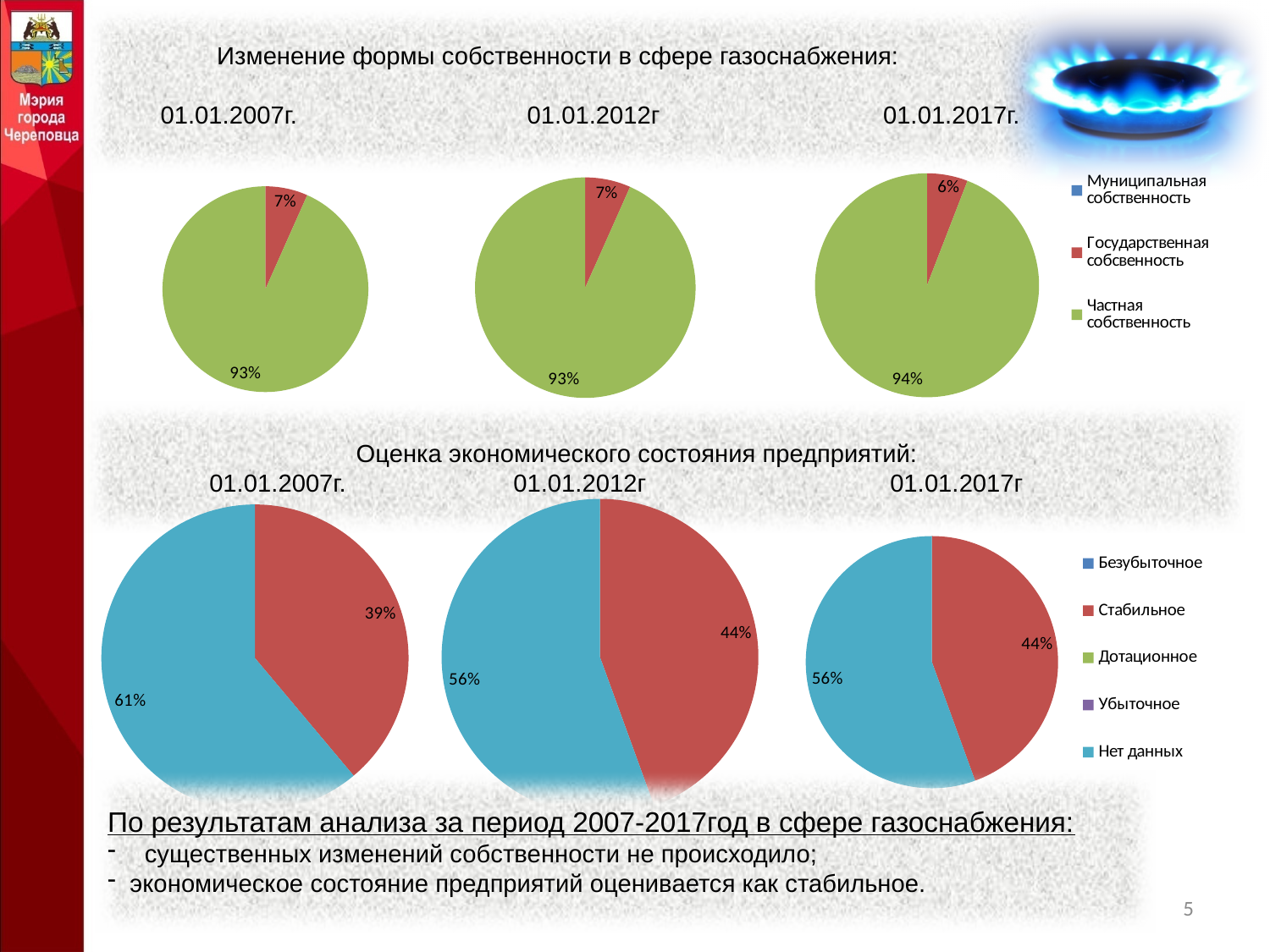
What type of chart is used for the top-row charts (Изменение формы собственности в сфере газоснабжения)? Pie chart In the bottom-row chart for 01.01.2017 (Оценка экономического состояния предприятий), what share is labelled for Стабильное? 44% In the top-row chart for 01.01.2017 (Изменение формы собственности в сфере газоснабжения), what share is labelled for Государственная собсвенность? 6% In the bottom-row chart for 01.01.2012 (Оценка экономического состояния предприятий), what share is labelled for Нет данных? 56% In the top-row chart for 01.01.2007 (Изменение формы собственности в сфере газоснабжения), what share is labelled for Частная собственность? 93% In the bottom-row chart for 01.01.2007, which is larger: the Стабильное slice or the Нет данных slice? Нет данных In the bottom-row chart for 01.01.2007, what is the difference between the Нет данных share and the Стабильное share? 22% In the top-row chart for 01.01.2017, which ownership form has the largest slice? Частная собственность In the top-row chart for 01.01.2012 (Изменение формы собственности в сфере газоснабжения), what share is labelled for Частная собственность? 93% In the top-row chart for 01.01.2007, what is the difference between the Частная собственность share and the Государственная собсвенность share? 86% How many entries does the legend of the bottom-row charts (Оценка экономического состояния предприятий) list? 5 In the bottom-row chart for 01.01.2007 (Оценка экономического состояния предприятий), what share is labelled for Стабильное? 39%